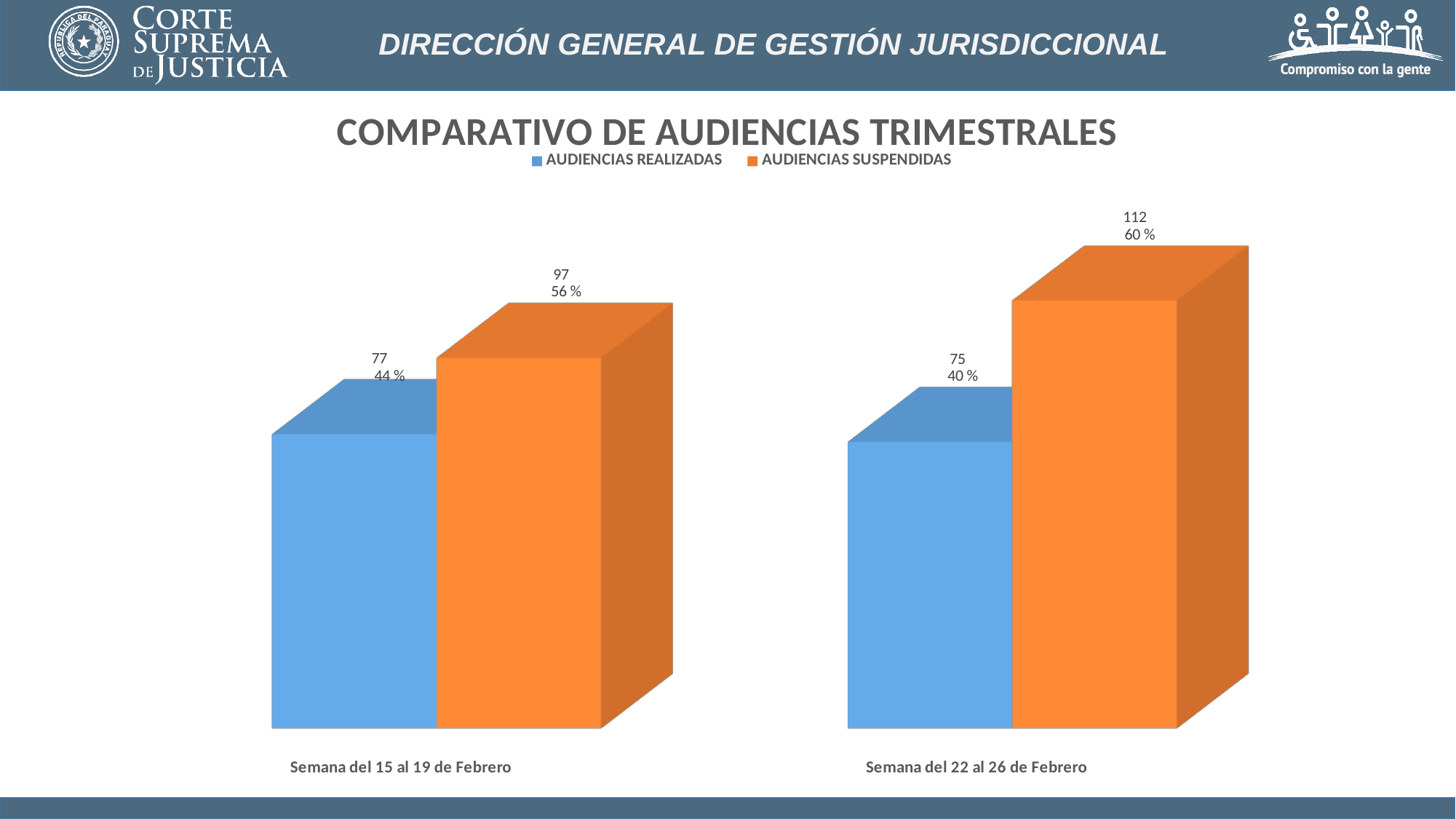
Which is larger: AUDIENCIAS SUSPENDIDAS for Semana del 15 al 19 de Febrero or AUDIENCIAS SUSPENDIDAS for Semana del 22 al 26 de Febrero? Semana del 22 al 26 de Febrero What is the difference between AUDIENCIAS SUSPENDIDAS and AUDIENCIAS REALIZADAS for Semana del 15 al 19 de Febrero? 20 What percentage is shown for AUDIENCIAS SUSPENDIDAS in Semana del 15 al 19 de Febrero? 56 % What is the value of AUDIENCIAS REALIZADAS for Semana del 15 al 19 de Febrero? 77 How many series does the legend list? 2 How many categories (weeks) are shown on the x axis? 2 What is the difference between AUDIENCIAS SUSPENDIDAS and AUDIENCIAS REALIZADAS for Semana del 22 al 26 de Febrero? 37 Which bar has the highest value on the chart? AUDIENCIAS SUSPENDIDAS, Semana del 22 al 26 de Febrero What percentage is shown for AUDIENCIAS REALIZADAS in Semana del 22 al 26 de Febrero? 40 % What is the value of AUDIENCIAS SUSPENDIDAS for Semana del 22 al 26 de Febrero? 112 What kind of chart is shown on the slide? Bar chart Which bar has the lowest value on the chart? AUDIENCIAS REALIZADAS, Semana del 22 al 26 de Febrero